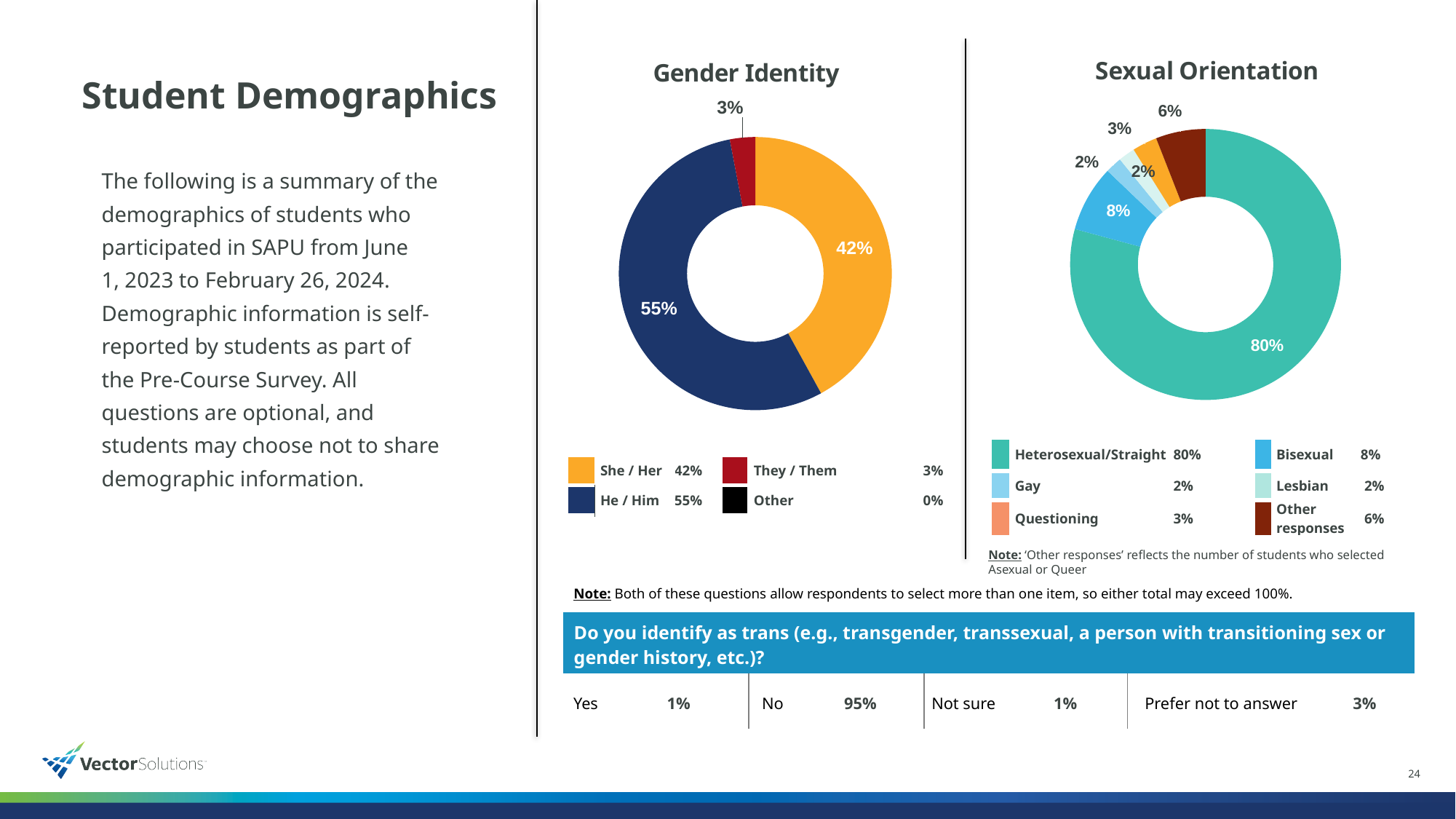
In the Sexual Orientation chart, what percentage of students selected Bisexual? 8% In the Sexual Orientation chart, which category has the largest share? Heterosexual/Straight In the Sexual Orientation chart, which is larger: Questioning or Lesbian? Questioning In the Gender Identity chart, how many categories does the legend list? 4 In the Sexual Orientation chart, what percentage of students selected Other responses? 6% In the Sexual Orientation chart, how many categories does the legend list? 6 In the Gender Identity chart, what colour is the He / Him slice? Dark navy blue In the Gender Identity chart, what percentage of students selected She / Her? 42% In the Gender Identity chart, what is the difference in percentage points between He / Him and She / Her? 13 In the Gender Identity chart, what percentage of students selected They / Them? 3% In the Gender Identity chart, which category has the largest share? He / Him What kind of chart is the Sexual Orientation chart? Pie chart (donut)